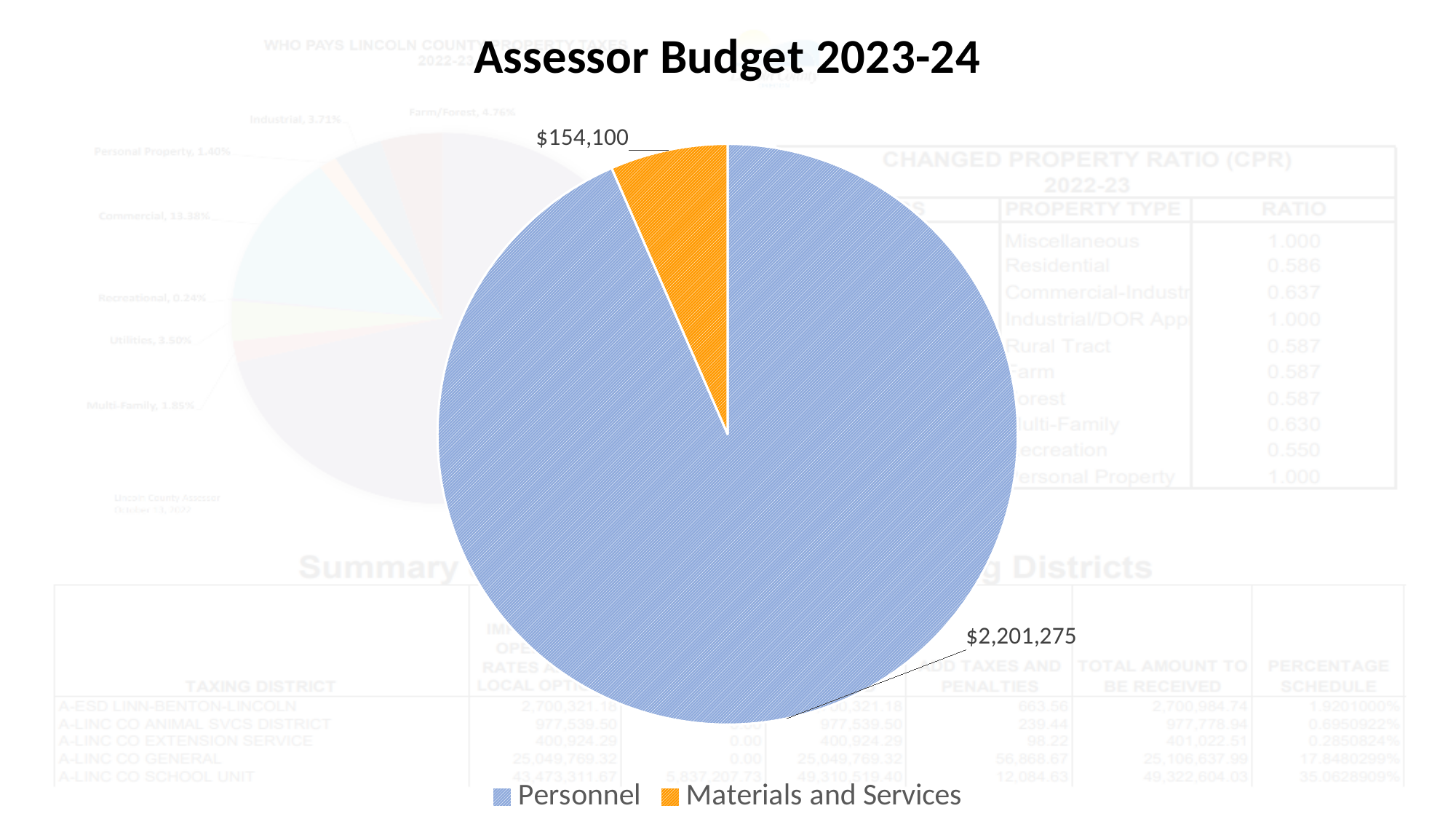
What is the difference between the Personnel value and the Materials and Services value? $2,047,175 What colour is the Materials and Services slice? orange How many entries does the legend list? 2 What is the title of the chart? Assessor Budget 2023-24 Which category has the smallest slice in the Assessor Budget 2023-24 pie chart? Materials and Services Which category has the largest slice in the Assessor Budget 2023-24 pie chart? Personnel What is the total of the two slices in the Assessor Budget 2023-24 pie chart? $2,355,375 What is the value of the Materials and Services slice in the Assessor Budget 2023-24 pie chart? $154,100 How many slices does the Assessor Budget 2023-24 pie chart have? 2 Which is larger, Personnel or Materials and Services? Personnel What is the value of the Personnel slice in the Assessor Budget 2023-24 pie chart? $2,201,275 What type of chart is shown on the slide? pie chart